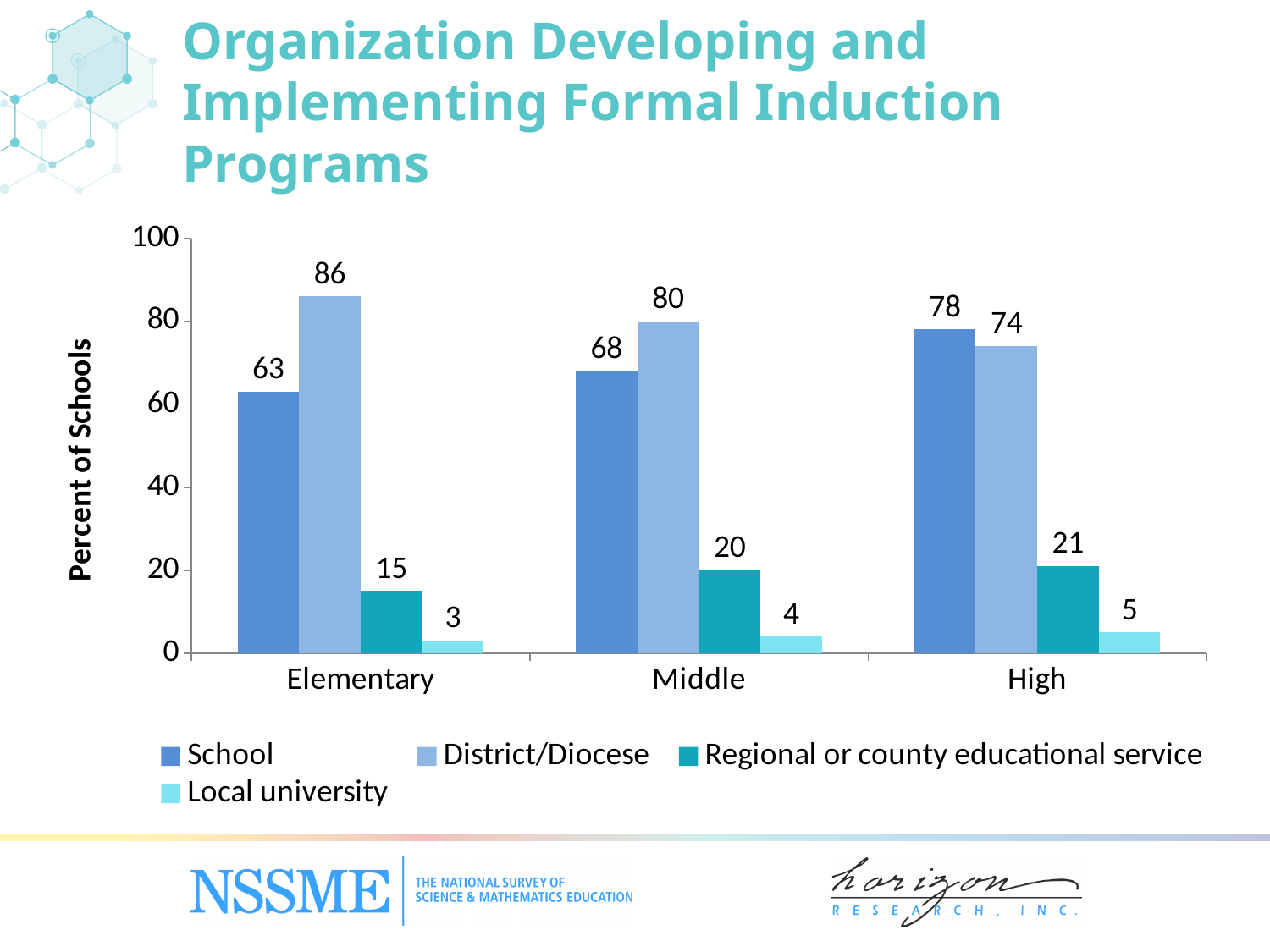
Which series has the lowest value in the Elementary category? Local university What kind of chart is shown on the slide? Bar chart Which is larger: the School value for Middle or the School value for High? High What is the label of the y axis? Percent of Schools How many series does the legend list? 4 What is the difference between the District/Diocese and School values in the Elementary category? 23 What is the value for Local university in the Middle category? 4 What is the value for Regional or county educational service in the High category? 21 How many categories are shown on the x axis? 3 Which series has the highest value in the High category? School Do the School values rise or fall from Elementary to High? Rise What is the value for District/Diocese in the Elementary category? 86